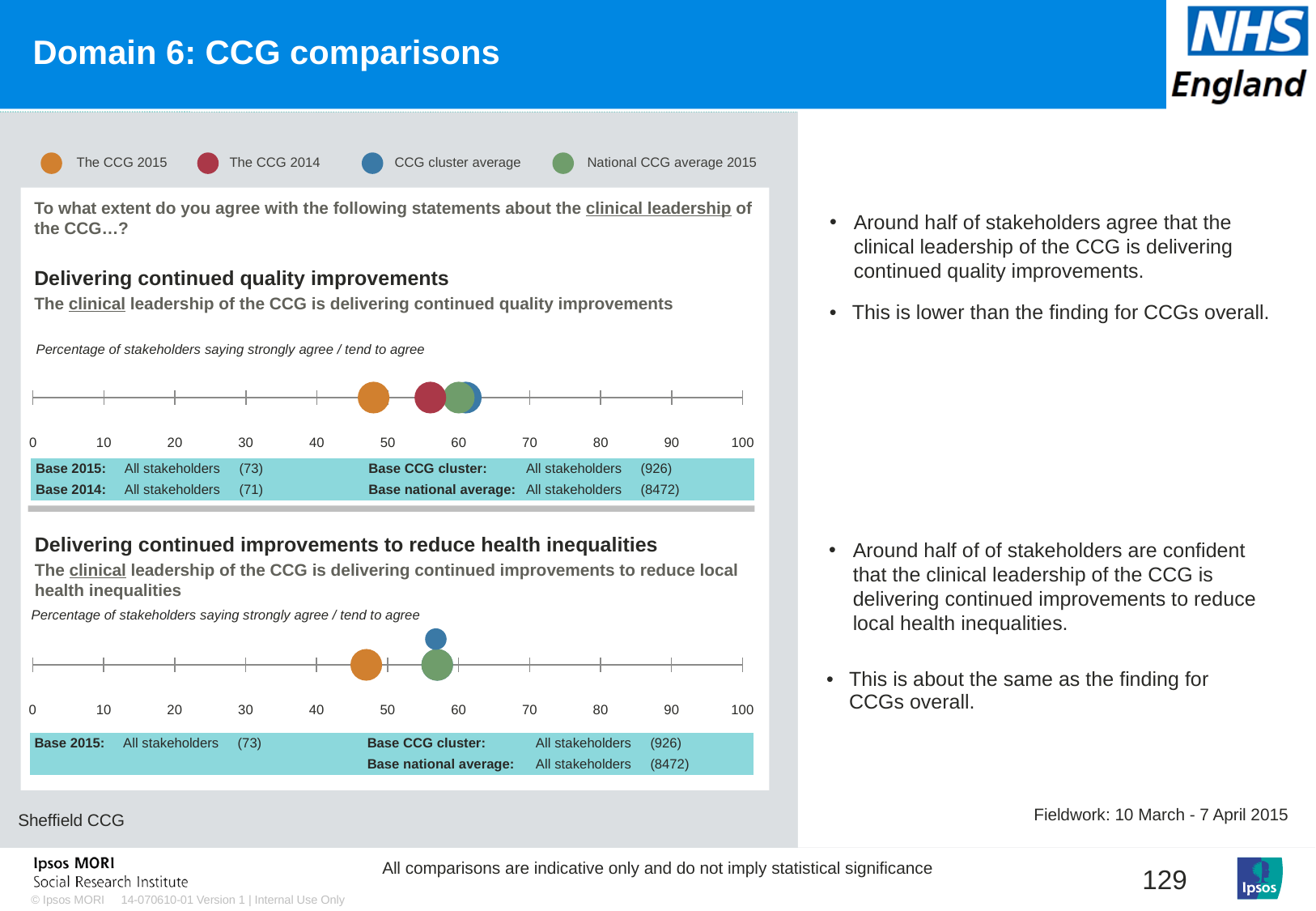
What is the highest value labelled on the x axis of the 'Delivering continued quality improvements' chart? 100 How many data points are plotted in the 'Delivering continued improvements to reduce health inequalities' chart? 3 In the 'Delivering continued improvements to reduce health inequalities' chart, which is larger: The CCG 2015 or the National CCG average 2015? National CCG average 2015 What colour does the legend use for The CCG 2015? Orange In the 'Delivering continued quality improvements' chart, which is larger: The CCG 2015 or The CCG 2014? The CCG 2014 In the 'Delivering continued quality improvements' chart, is the value for The CCG 2015 greater or less than 60? less In the 'Delivering continued quality improvements' chart, which series has the lowest value? The CCG 2015 In the 'Delivering continued improvements to reduce health inequalities' chart, is the value for The CCG 2015 greater or less than 60? less In the 'Delivering continued quality improvements' chart, is the value for The CCG 2014 greater or less than 50? greater How many series does the legend at the top of the slide list? 4